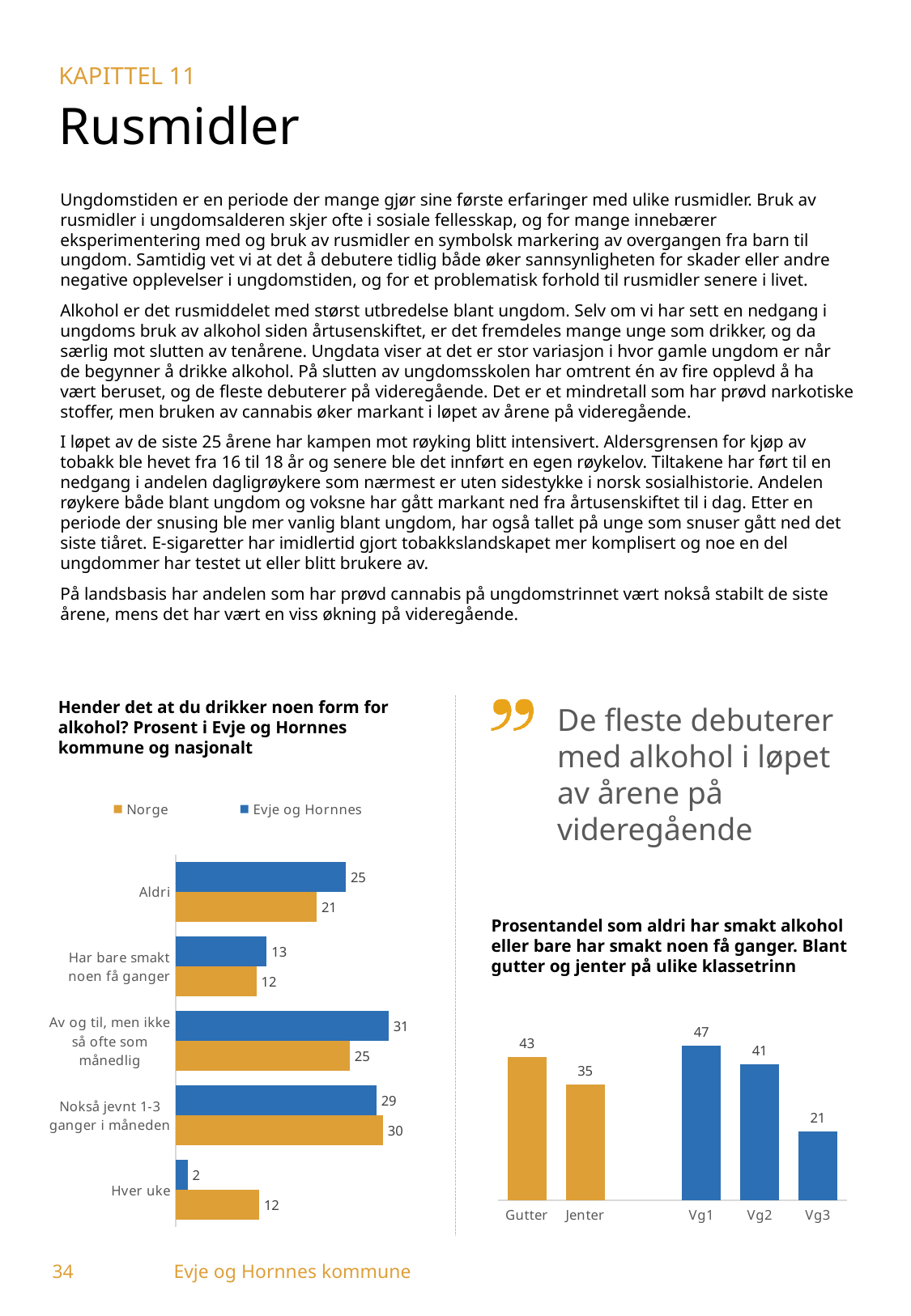
In the chart 'Hender det at du drikker noen form for alkohol?', what is the difference between Evje og Hornnes and Norge in the 'Av og til, men ikke så ofte som månedlig' category? 6 In the chart 'Hender det at du drikker noen form for alkohol?', what is the value for Evje og Hornnes in the 'Aldri' category? 25 In the chart 'Hender det at du drikker noen form for alkohol?', how many series does the legend list? 2 In the chart 'Hender det at du drikker noen form for alkohol?', what is the value for Norge in the 'Hver uke' category? 12 In the chart 'Prosentandel som aldri har smakt alkohol eller bare har smakt noen få ganger', which category has the lowest value? Vg3 In the chart 'Hender det at du drikker noen form for alkohol?', which category has the lowest value for Evje og Hornnes? Hver uke In the chart 'Prosentandel som aldri har smakt alkohol eller bare har smakt noen få ganger', what is the value for Vg1? 47 In the chart 'Prosentandel som aldri har smakt alkohol eller bare har smakt noen få ganger', what is the difference between Gutter and Jenter? 8 What kind of chart is 'Prosentandel som aldri har smakt alkohol eller bare har smakt noen få ganger'? Bar chart In the chart 'Hender det at du drikker noen form for alkohol?', how many categories are shown? 5 In the chart 'Hender det at du drikker noen form for alkohol?', which category has the highest value for Evje og Hornnes? Av og til, men ikke så ofte som månedlig In the chart 'Hender det at du drikker noen form for alkohol?', which is larger in the 'Hver uke' category: Norge or Evje og Hornnes? Norge